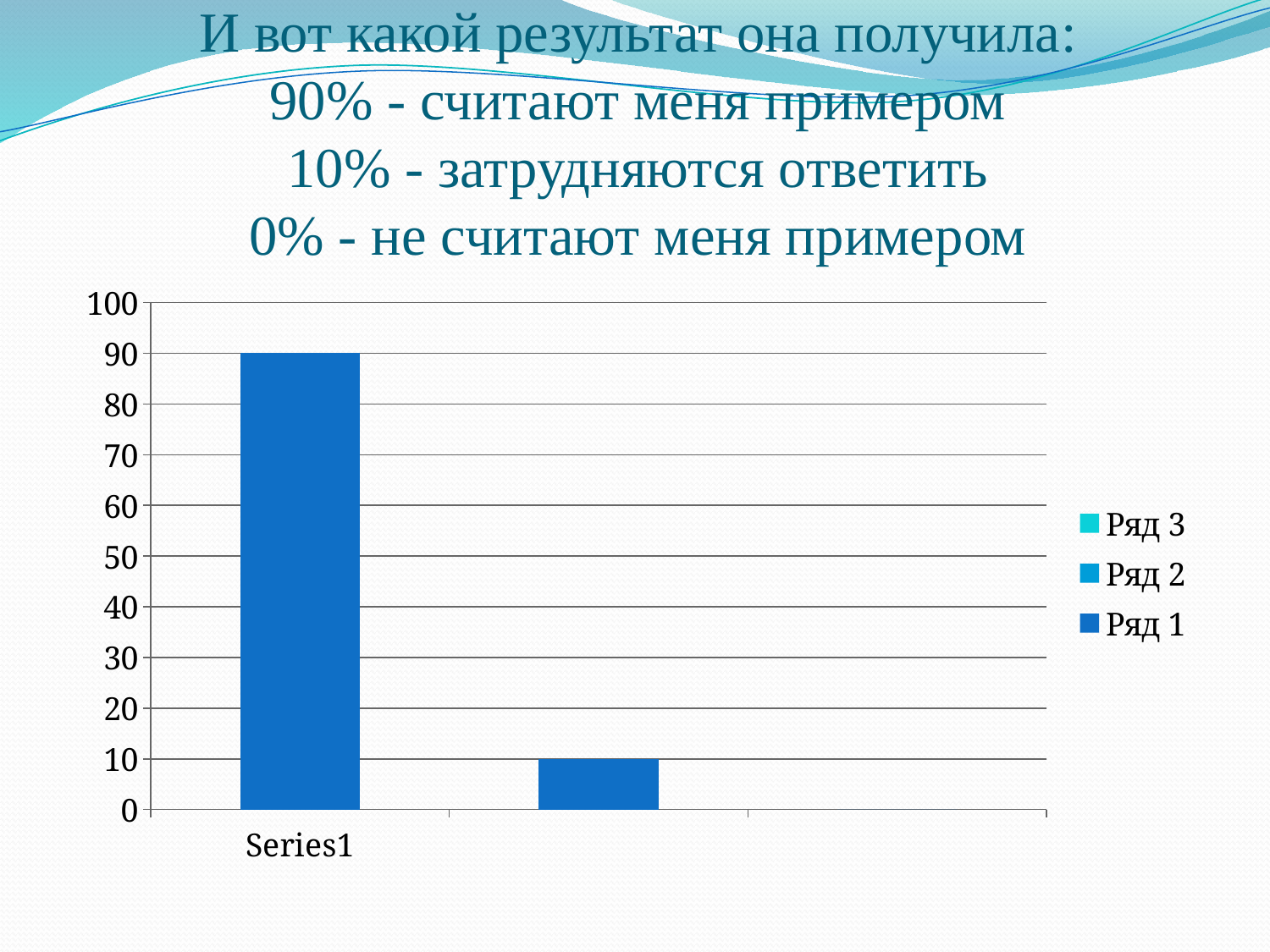
Do the bar values rise or fall from left to right along the x axis? fall Is the value for Series1 greater or less than 50? greater Which bar on the chart is the tallest? Series1 What are the entries listed in the chart legend? Ряд 3, Ряд 2, Ряд 1 What is the value of the bar for Series1? 90 How many series does the chart legend list? 3 What is the highest value shown on the vertical axis? 100 What kind of chart is shown on the slide? bar chart